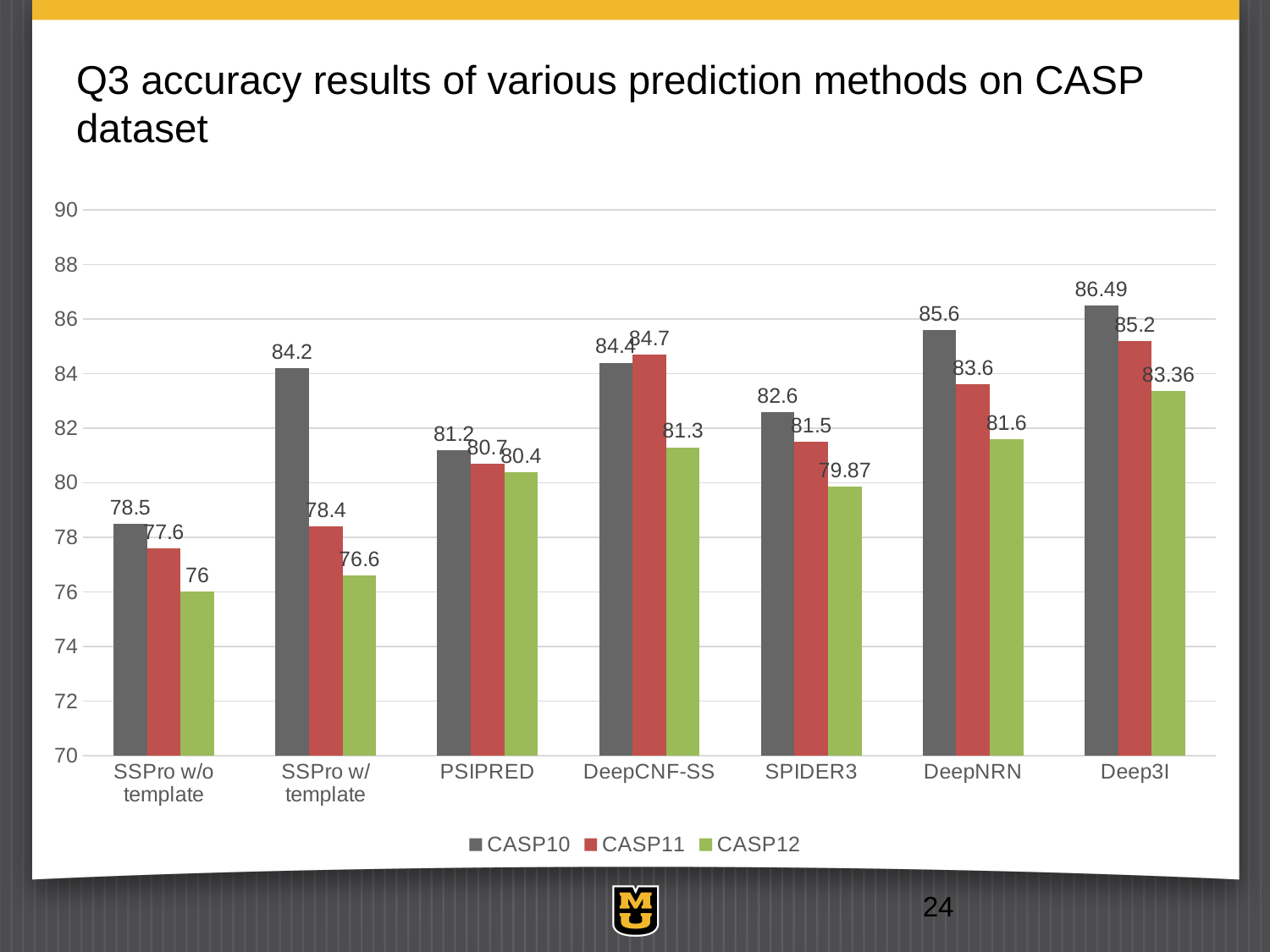
What is the difference between the CASP10 values for Deep3I and DeepNRN? 0.89 How many series does the legend list? 3 Which method has the lowest CASP12 value? SSPro w/o template Which series is shown in green in the legend? CASP12 What is the CASP10 value for Deep3I? 86.49 Which is larger, the CASP11 value for DeepCNF-SS or the CASP11 value for DeepNRN? DeepCNF-SS Which method has the highest CASP10 value? Deep3I What kind of chart is shown on the slide? bar chart How many prediction methods are shown on the x axis? 7 What is the CASP11 value for SSPro w/o template? 77.6 Is the CASP12 value for PSIPRED greater or less than 82? less What is the CASP12 value for SPIDER3? 79.87